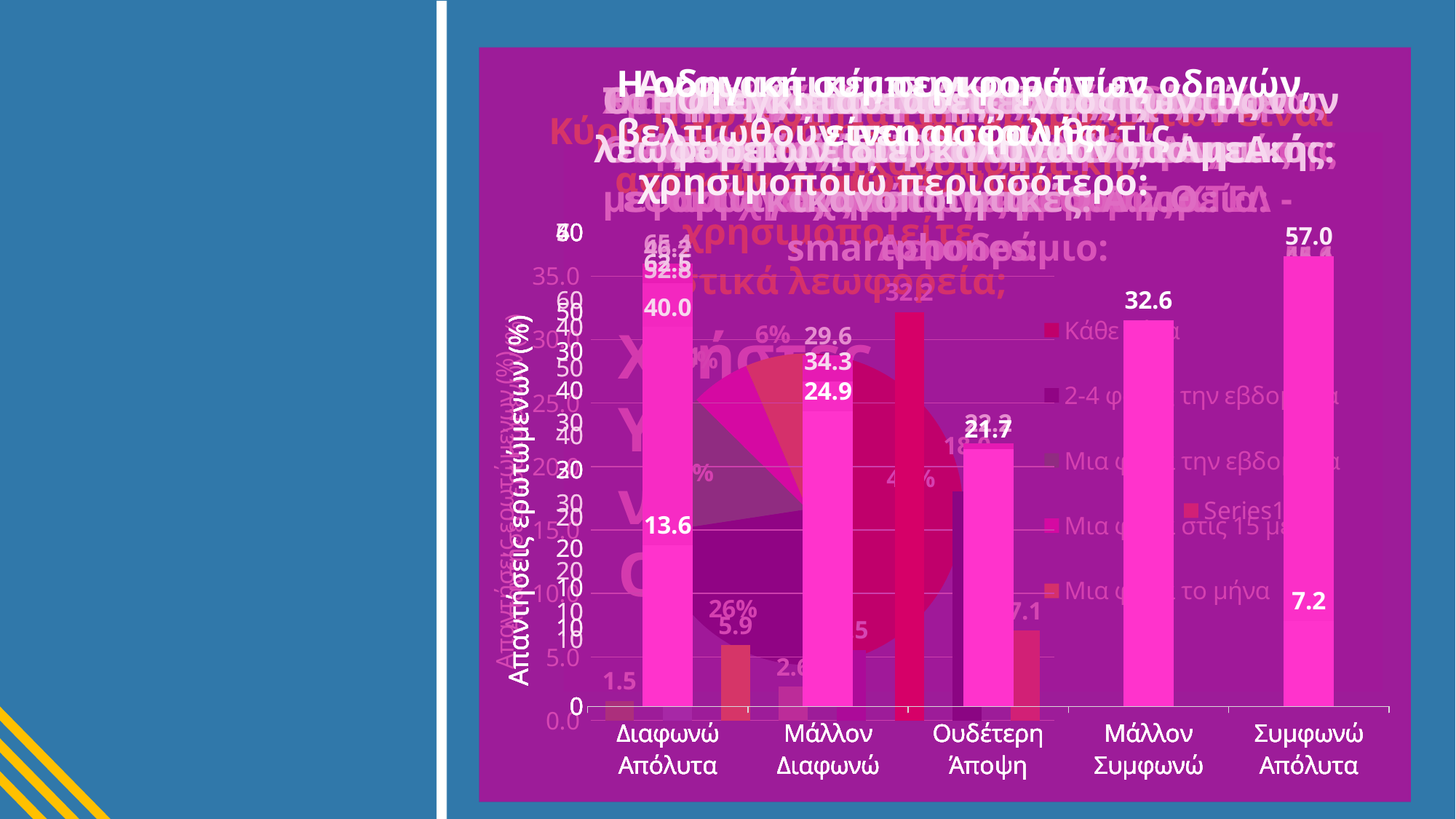
What value is printed at the top of the tallest bar for Συμφωνώ Απόλυτα? 57.0 What kind of chart is drawn in front on this slide? bar chart How many categories are labelled along the x axis of the bar chart? 5 What value is printed at the top of the bar for Μάλλον Συμφωνώ? 32.6 Which is larger, the value printed at the top of the Συμφωνώ Απόλυτα bar (57.0) or the value printed at the top of the Μάλλον Συμφωνώ bar (32.6)? Συμφωνώ Απόλυτα What is the label of the last category on the x axis of the bar chart? Συμφωνώ Απόλυτα What is the title of the vertical axis of the bar chart? Απαντήσεις ερωτώμενων (%) What is the difference between the value printed at the top of the Συμφωνώ Απόλυτα bar (57.0) and the value printed at the top of the Μάλλον Συμφωνώ bar (32.6)? 24.4